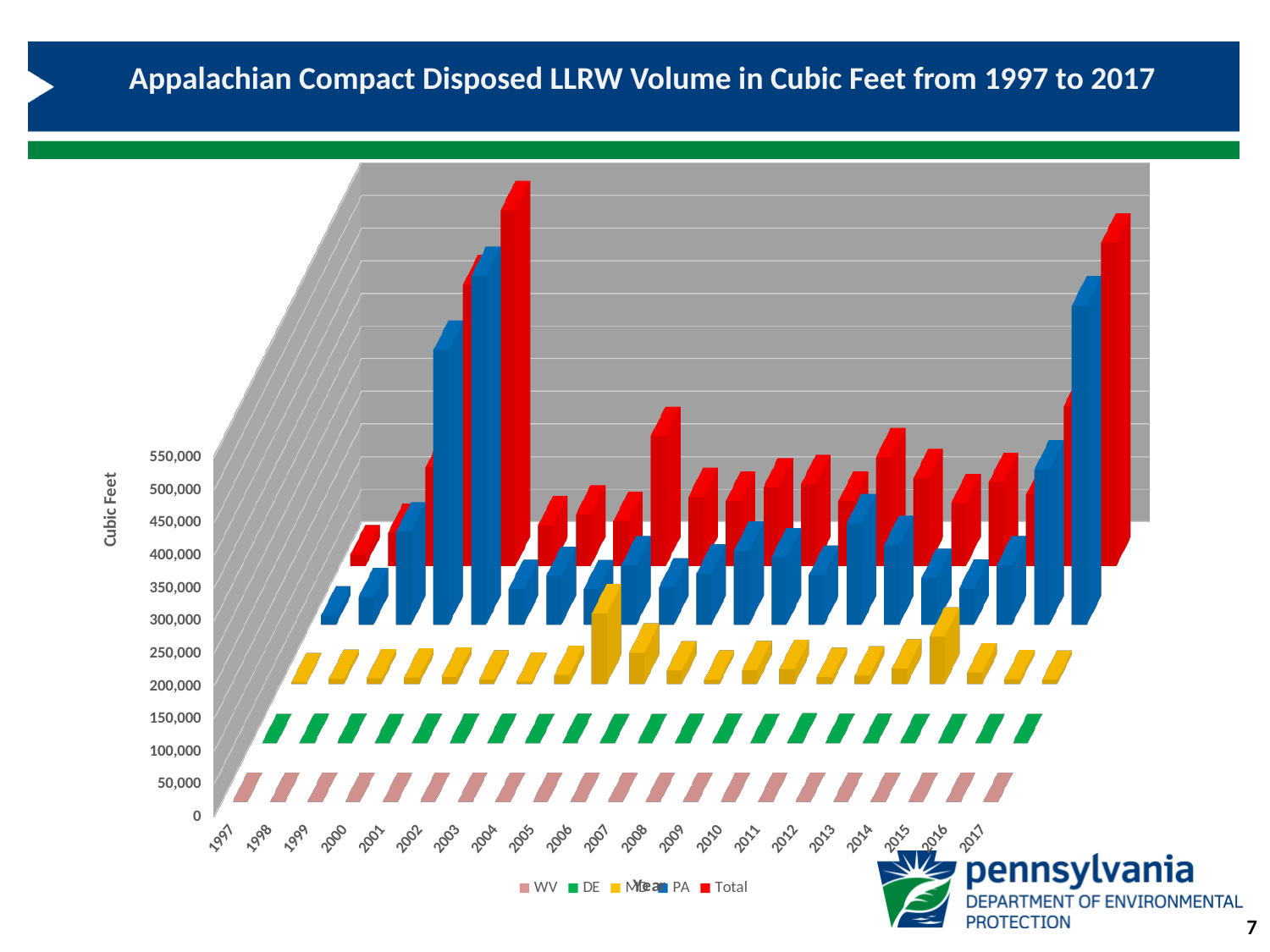
How many years are shown along the x axis? 21 Does the Total series rise or fall from 2003 to 2005? Rise Which is larger, the PA value for 2017 or the PA value for 2010? 2017 Which is larger, the Total for 2003 or the Total for 2008? 2008 In which year is the PA series highest? 2001 Which is larger, the Total for 2017 or the Total for 2012? 2017 What is the title of the chart? Appalachian Compact Disposed LLRW Volume in Cubic Feet from 1997 to 2017 What is the label on the vertical axis? Cubic Feet What kind of chart is shown on the slide? Bar chart How many series does the legend list? 5 In which year is the Total series highest? 2001 Does the Total series rise or fall from 2015 to 2017? Rise